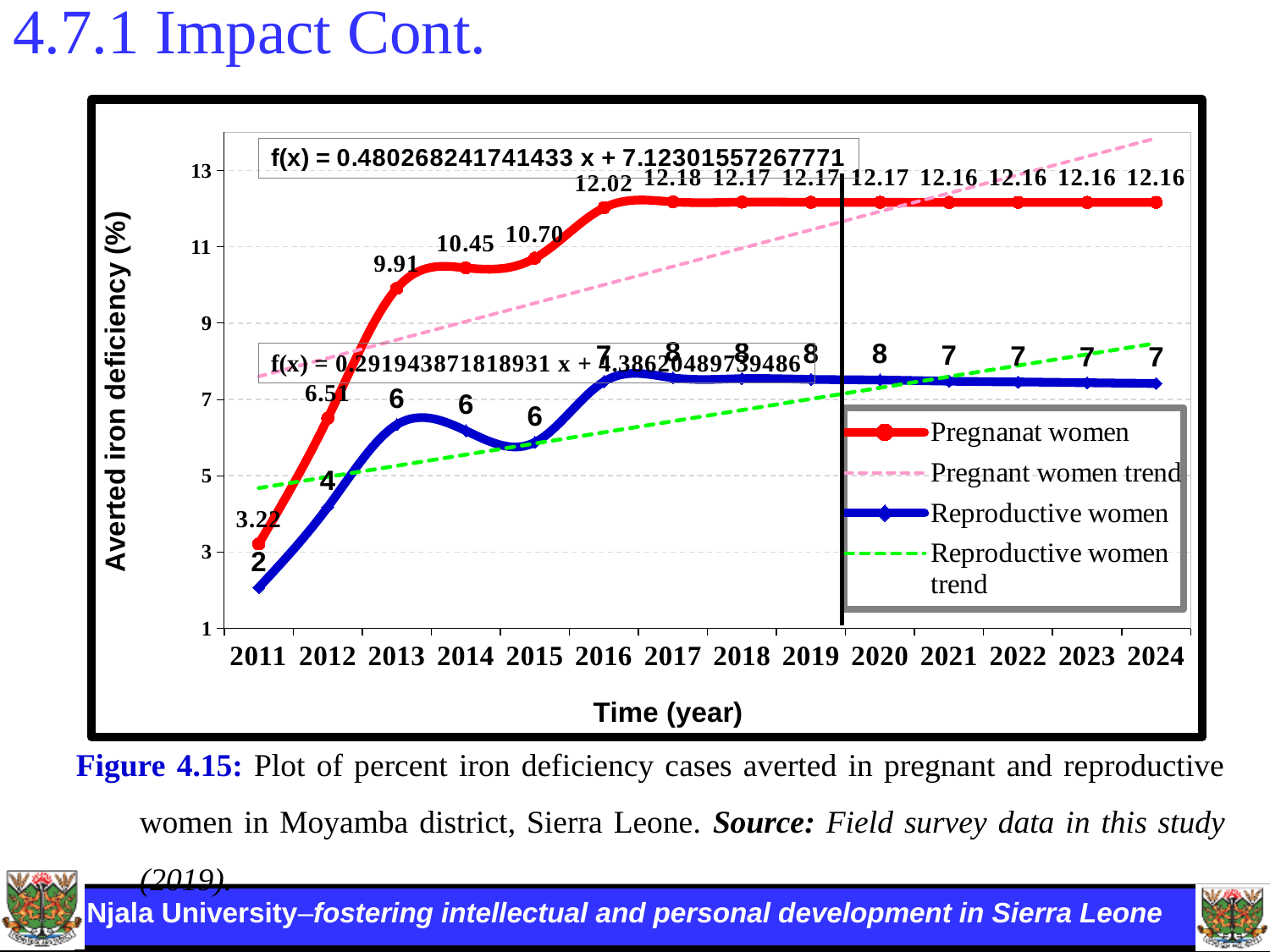
Does the pregnant women series rise or fall from 2011 to 2016? Rise What is the averted iron deficiency value for pregnant women in 2011? 3.22 What is the averted iron deficiency value for reproductive women in 2012? 4 In which year is the pregnant women value highest? 2017 How many years are shown on the x axis? 14 How many entries does the legend list? 4 What kind of chart is shown on the slide? Line chart Which is larger in 2015: the pregnant women value or the reproductive women value? Pregnant women What is the averted iron deficiency value for reproductive women in 2024? 7 What is the difference between the pregnant women values in 2013 and 2012? 3.40 What is the averted iron deficiency value for pregnant women in 2016? 12.02 In which year is the pregnant women value lowest? 2011